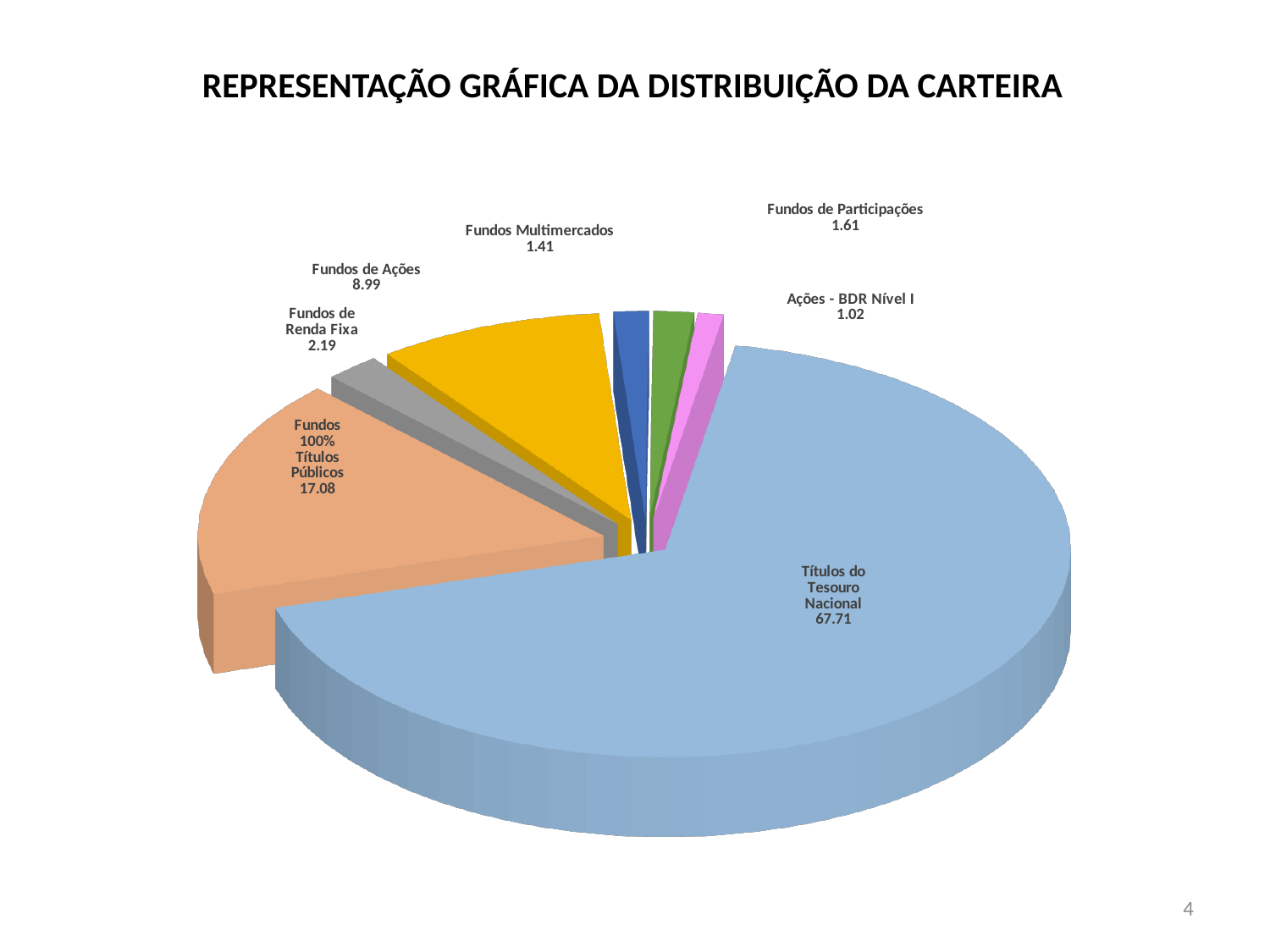
What is the value shown for Fundos de Ações? 8.99 What is the value shown for Fundos 100% Títulos Públicos? 17.08 What type of chart is shown on the slide? Pie chart How many slices does the pie chart have? 7 Which category has the largest slice of the pie? Títulos do Tesouro Nacional What is the value shown for Fundos de Renda Fixa? 2.19 Which is larger, Fundos de Participações or Fundos Multimercados? Fundos de Participações What is the value shown for Títulos do Tesouro Nacional? 67.71 What is the value shown for Ações - BDR Nível I? 1.02 What is the title of the slide? REPRESENTAÇÃO GRÁFICA DA DISTRIBUIÇÃO DA CARTEIRA Which category has the smallest slice of the pie? Ações - BDR Nível I What is the difference between the values for Títulos do Tesouro Nacional and Fundos 100% Títulos Públicos? 50.63